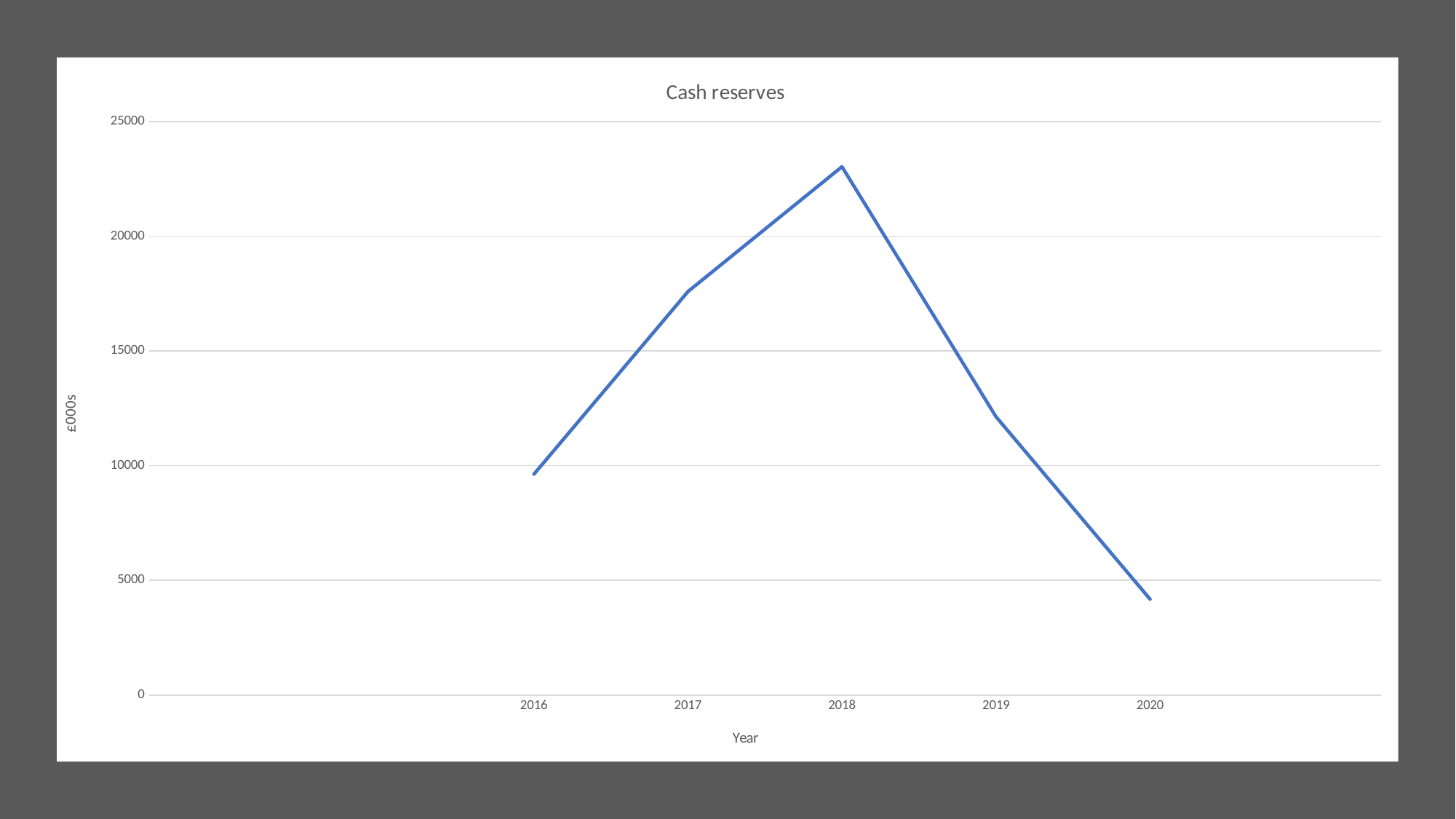
Which year has the lowest cash reserves? 2020 Is the value for 2016 greater or less than 10000? less What is the title of the chart? Cash reserves How many years are plotted on the x axis? 5 Is the value for 2018 greater or less than 20000? greater Is the value for 2017 greater or less than 15000? greater What kind of chart is shown on the slide? line chart Which year has the highest cash reserves? 2018 Do the values rise or fall from 2018 to 2020? fall Which year has the larger value, 2017 or 2019? 2017 What is the label on the vertical axis? £000s